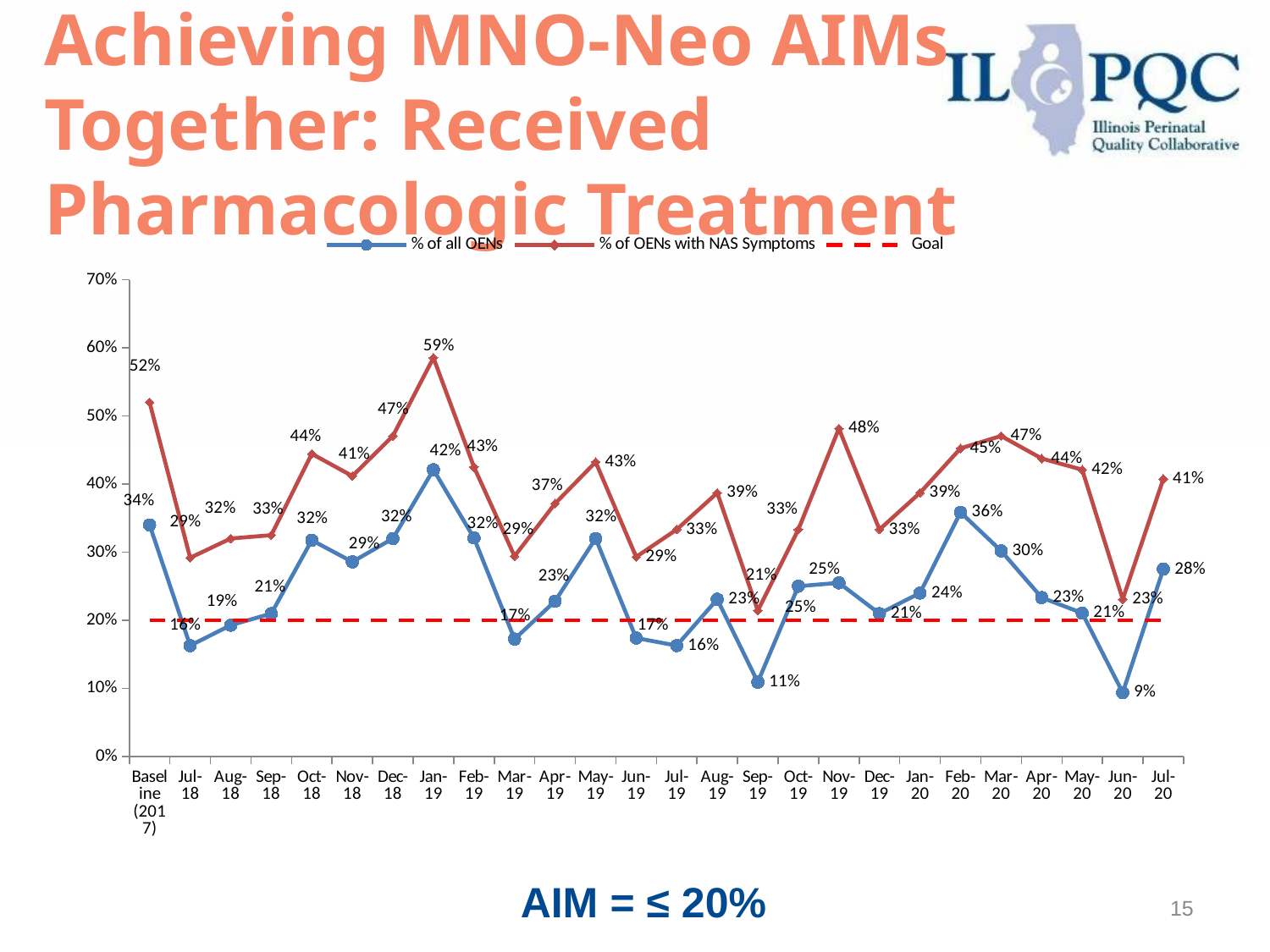
What is the value of the "% of OENs with NAS Symptoms" series for Jul-20? 41% How many entries does the legend list? 3 Which is higher for the "% of OENs with NAS Symptoms" series: Nov-19 or Feb-20? Nov-19 In which month does the "% of all OENs" series reach its lowest value? Jun-20 What is the value of the "% of all OENs" series for Jan-19? 42% What is the value of the "% of all OENs" series for Sep-19? 11% By how much did the "% of all OENs" value increase from Jan-20 to Feb-20? 12 percentage points In which month does the "% of OENs with NAS Symptoms" series reach its highest value? Jan-19 How many time points are plotted on the x axis, including the baseline? 26 What kind of chart is shown on the slide? Line chart Is the "% of all OENs" value for Jun-20 greater or less than 20%? less What is the difference between the "% of OENs with NAS Symptoms" value and the "% of all OENs" value in Jan-19? 17 percentage points